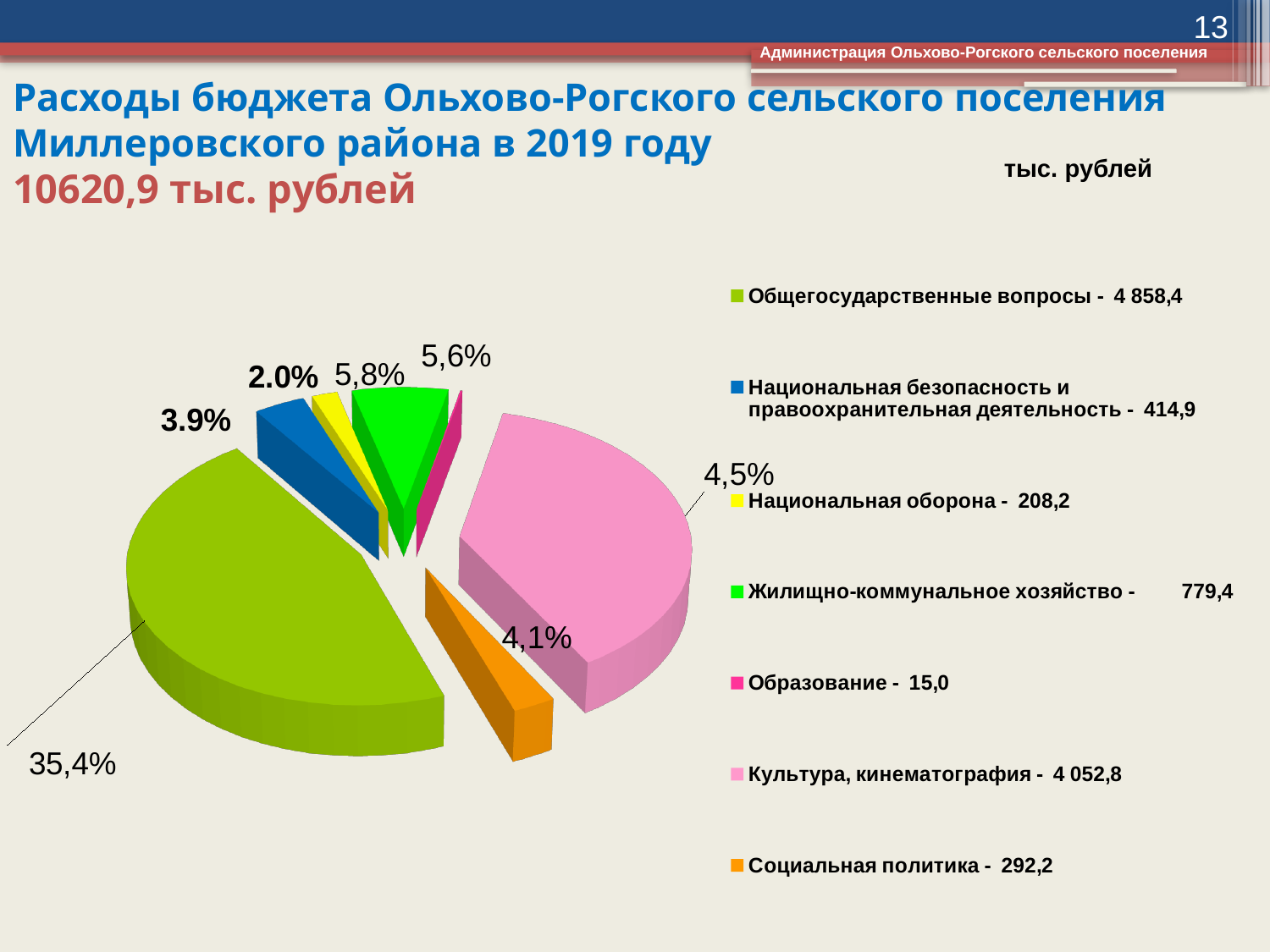
Which category has the smallest value? Образование What is the difference between Общегосударственные вопросы and Культура, кинематография? 805,6 What value is given for Национальная оборона? 208,2 What value is given for Культура, кинематография? 4 052,8 Which is larger: Жилищно-коммунальное хозяйство or Социальная политика? Жилищно-коммунальное хозяйство What value is given for Социальная политика? 292,2 What kind of chart is shown on the slide? Pie chart Which category has the largest value? Общегосударственные вопросы What value is given for Общегосударственные вопросы? 4 858,4 How many categories does the pie chart show? 7 How many entries does the legend list? 7 What value is given for Образование? 15,0